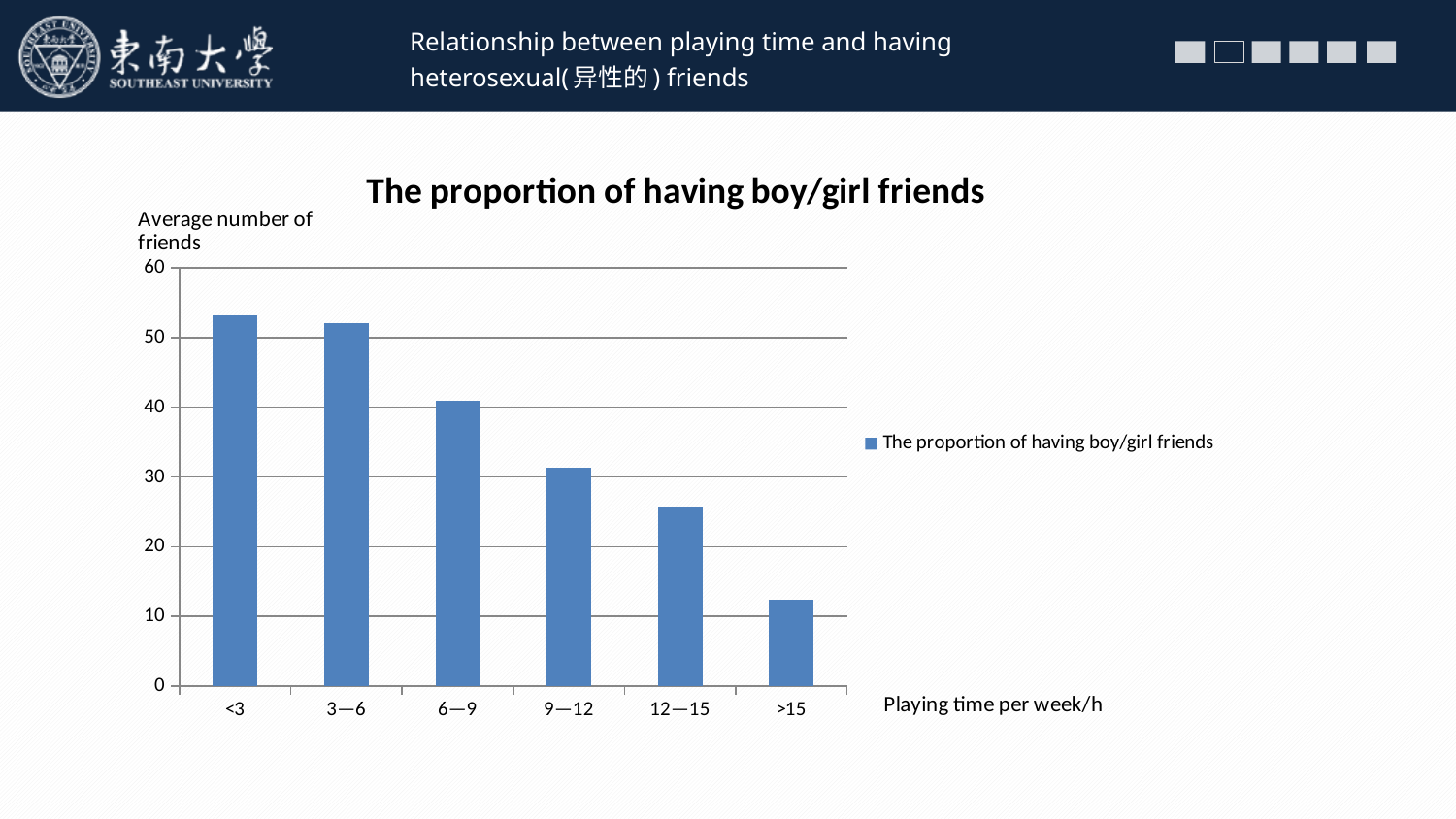
How many series does the legend list? 1 Is the value for <3 greater or less than 50? greater Is the value for 9—12 greater or less than 30? greater Which has the larger value, 6—9 or 9—12? 6—9 Is the value for >15 greater or less than 20? less Do the values rise or fall as playing time per week increases along the x axis? fall What is the title of the chart? The proportion of having boy/girl friends What kind of chart is shown on the slide? bar chart Which playing-time category has the lowest value? >15 How many playing-time categories are shown on the x axis? 6